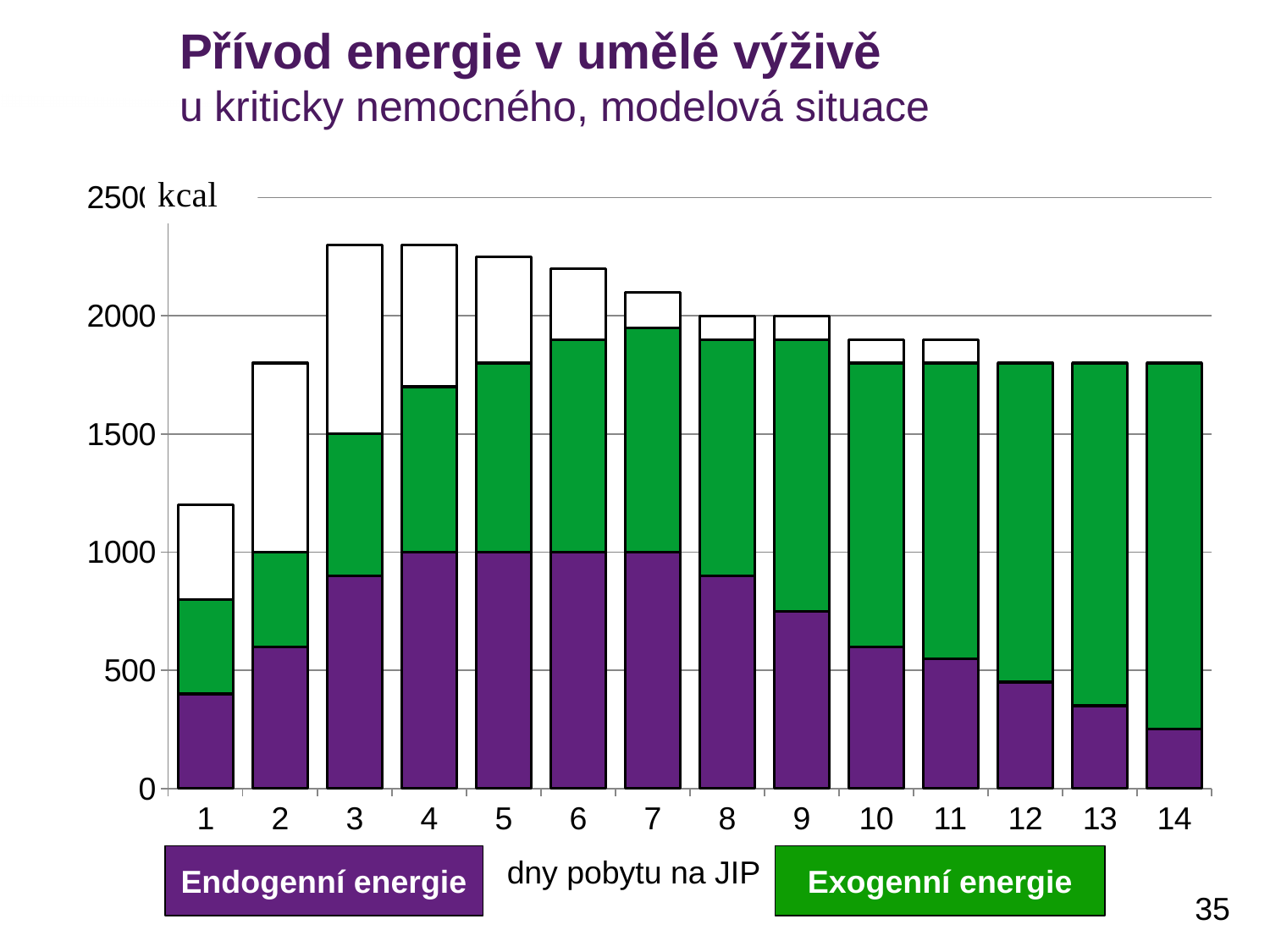
Is the total height of the bar for day 10 greater or less than 2000? less How many days (categories) are plotted on the x axis? 14 Is the total height of the bar for day 3 greater or less than 2000? greater What is the label of the x axis? dny pobytu na JIP Is the Endogenní energie value for day 14 greater or less than 500? less Which series is shown in purple according to the legend? Endogenní energie Does the Endogenní energie value rise or fall from day 7 to day 14? fall Which day has the lowest total bar? 1 Which is larger, the Endogenní energie value for day 2 or for day 13? day 2 What kind of chart is shown on the slide? bar chart